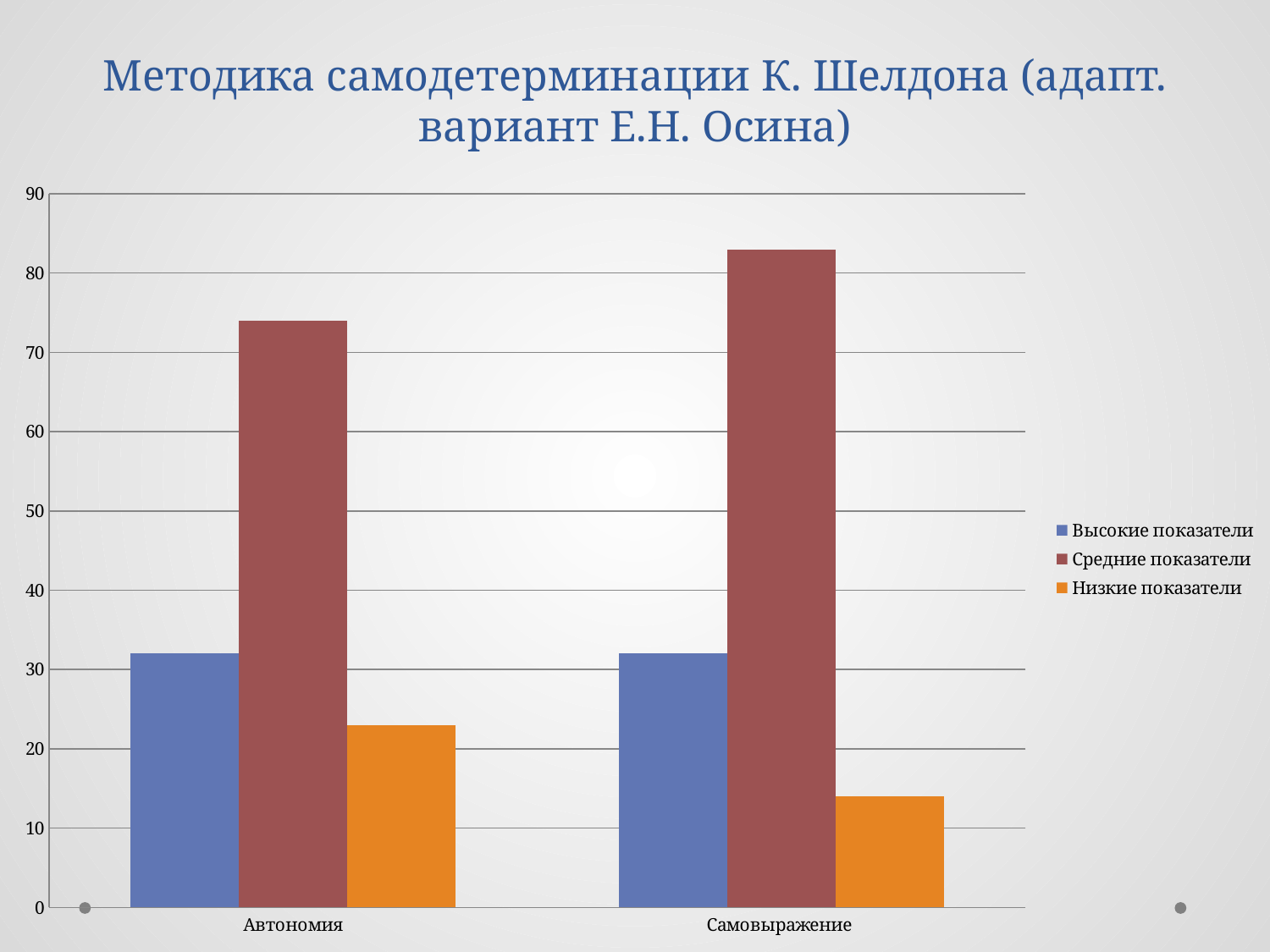
Is the value of Средние показатели for Автономия greater or less than 70? greater Is the value of Низкие показатели for Самовыражение greater or less than 20? less How many categories are shown on the x axis? 2 Is the value of Средние показатели for Самовыражение greater or less than 80? greater What colour are the bars for Низкие показатели? orange Which is larger: Низкие показатели for Автономия or Низкие показатели for Самовыражение? Автономия Which series has the lowest value for Самовыражение? Низкие показатели Which is larger: Средние показатели for Автономия or Средние показатели for Самовыражение? Самовыражение Which series has the highest value for Автономия? Средние показатели How many series does the legend list? 3 What kind of chart is shown on the slide? bar chart